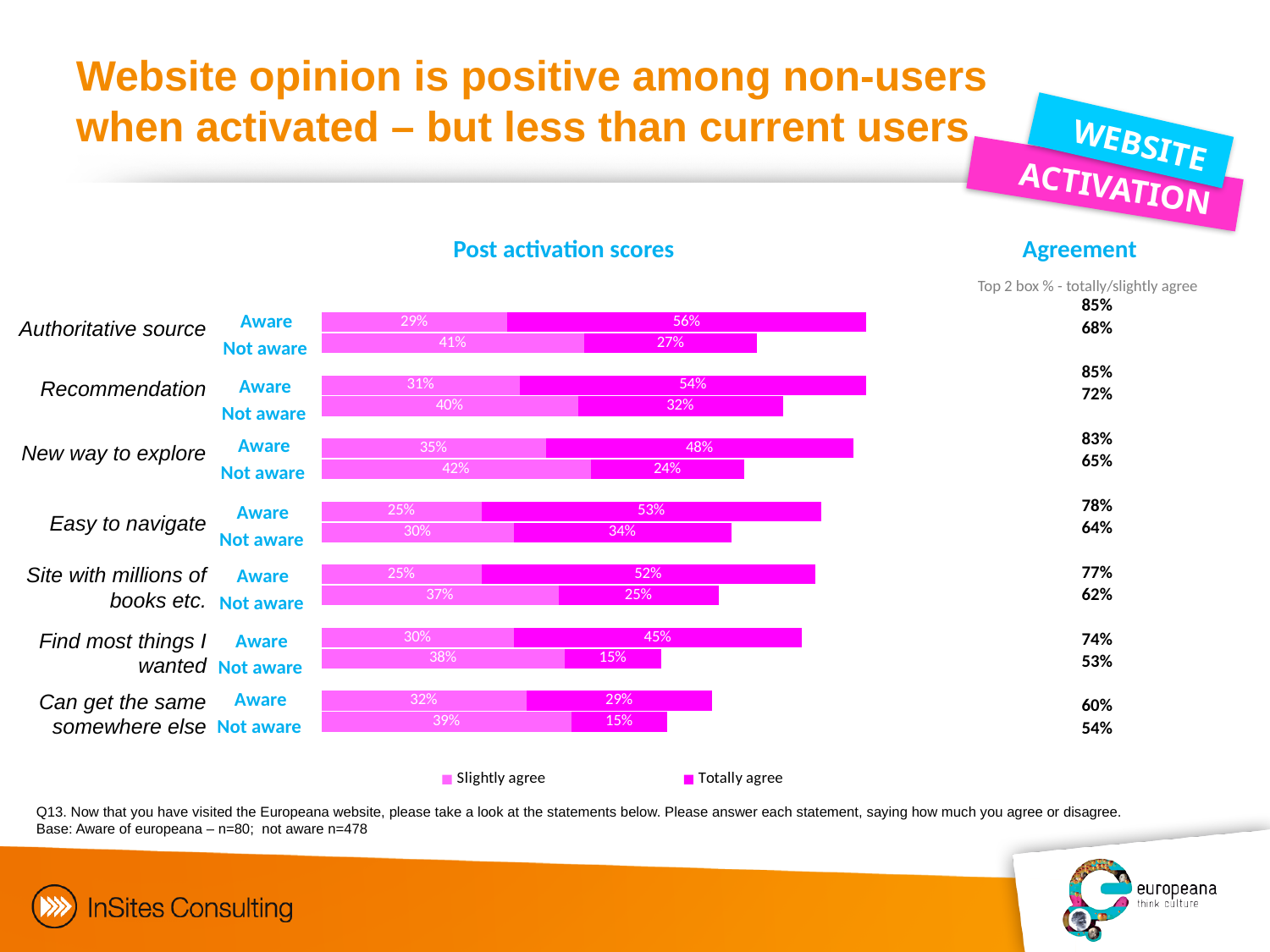
For New way to explore, is the Slightly agree value larger for Aware or Not aware? Not aware What is the Totally agree value for Find most things I wanted among those Not aware? 15% Which statement has the highest Totally agree value among those Aware? Authoritative source What is the Totally agree value for Authoritative source among those Aware? 56% What kind of chart is shown on the slide? Stacked bar chart What is the difference in Totally agree between Aware and Not aware for Recommendation? 22 percentage points What is the Slightly agree value for Easy to navigate among those Not aware? 30% How many series does the legend list? 2 What is the total of the stacked bar for Authoritative source, Aware? 85% How many statements are shown in the chart? 7 What is the total of the stacked bar for Find most things I wanted, Not aware? 53% Which statement has the lowest Totally agree value among those Aware? Can get the same somewhere else